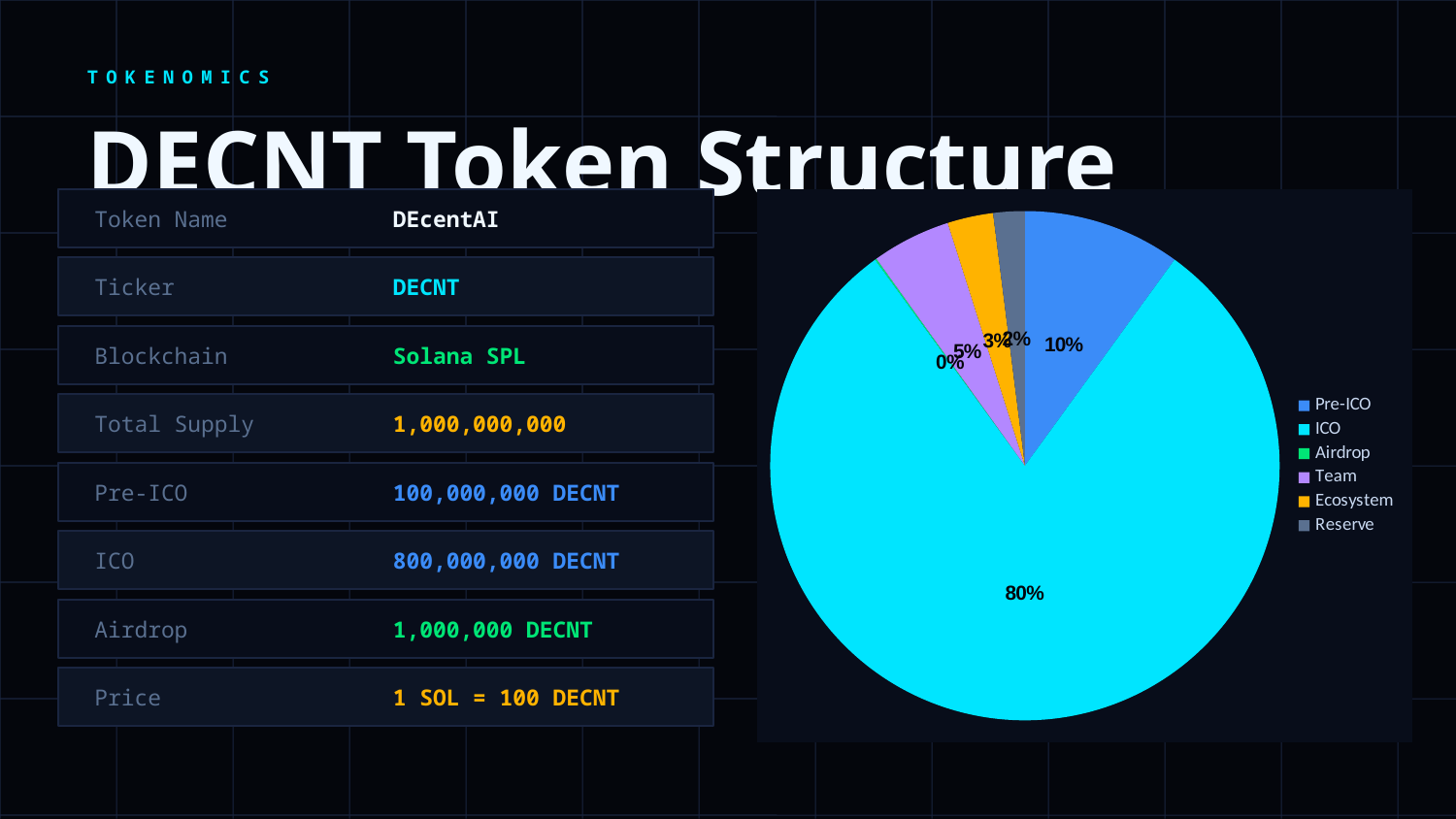
How many categories does the legend list? 6 What share of the pie does Pre-ICO hold? 10% Which legend entry is listed first? Pre-ICO What share of the pie does Airdrop hold? 0% Which category has the largest slice of the pie? ICO Which is larger, the Pre-ICO slice or the Team slice? Pre-ICO What kind of chart is shown on the slide? pie chart What is the difference in percentage points between the ICO slice and the Pre-ICO slice? 70 What share of the pie does ICO hold? 80% What colour is the ICO slice in the pie chart? cyan Which category has the smallest slice of the pie? Airdrop What share of the pie does Team hold? 5%